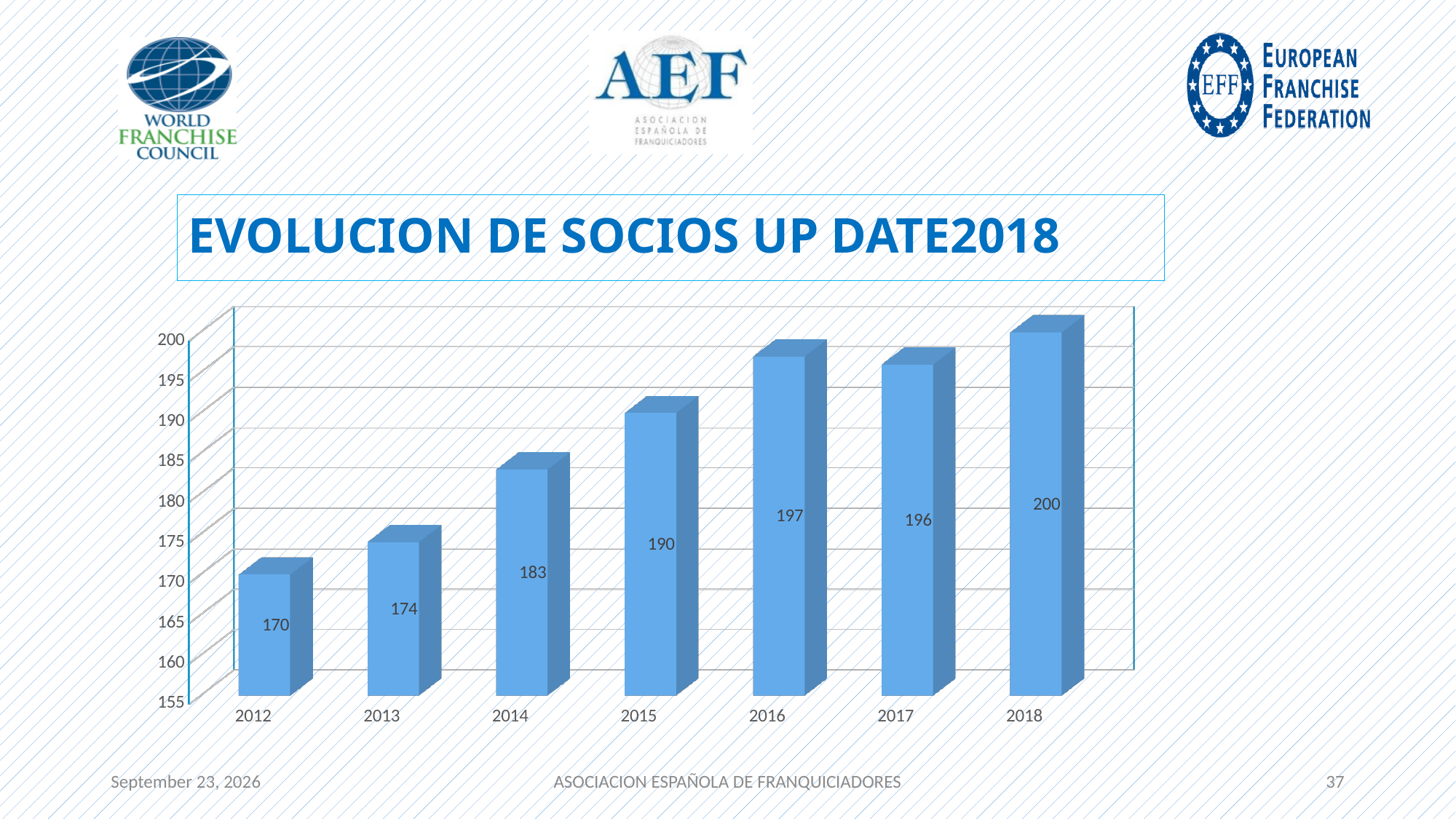
Is the value for 2014 greater or less than 180? greater What is the value for 2012? 170 What is the difference between the values for 2014 and 2013? 9 How many years are shown on the x axis? 7 What is the value for 2015? 190 What is the value for 2017? 196 What is the difference between the values for 2018 and 2012? 30 What kind of chart is shown on the slide? bar chart What is the title of the chart? EVOLUCION DE SOCIOS UP DATE2018 Which year has the highest value? 2018 Which year has the lowest value? 2012 Which is larger, the value for 2016 or the value for 2017? 2016